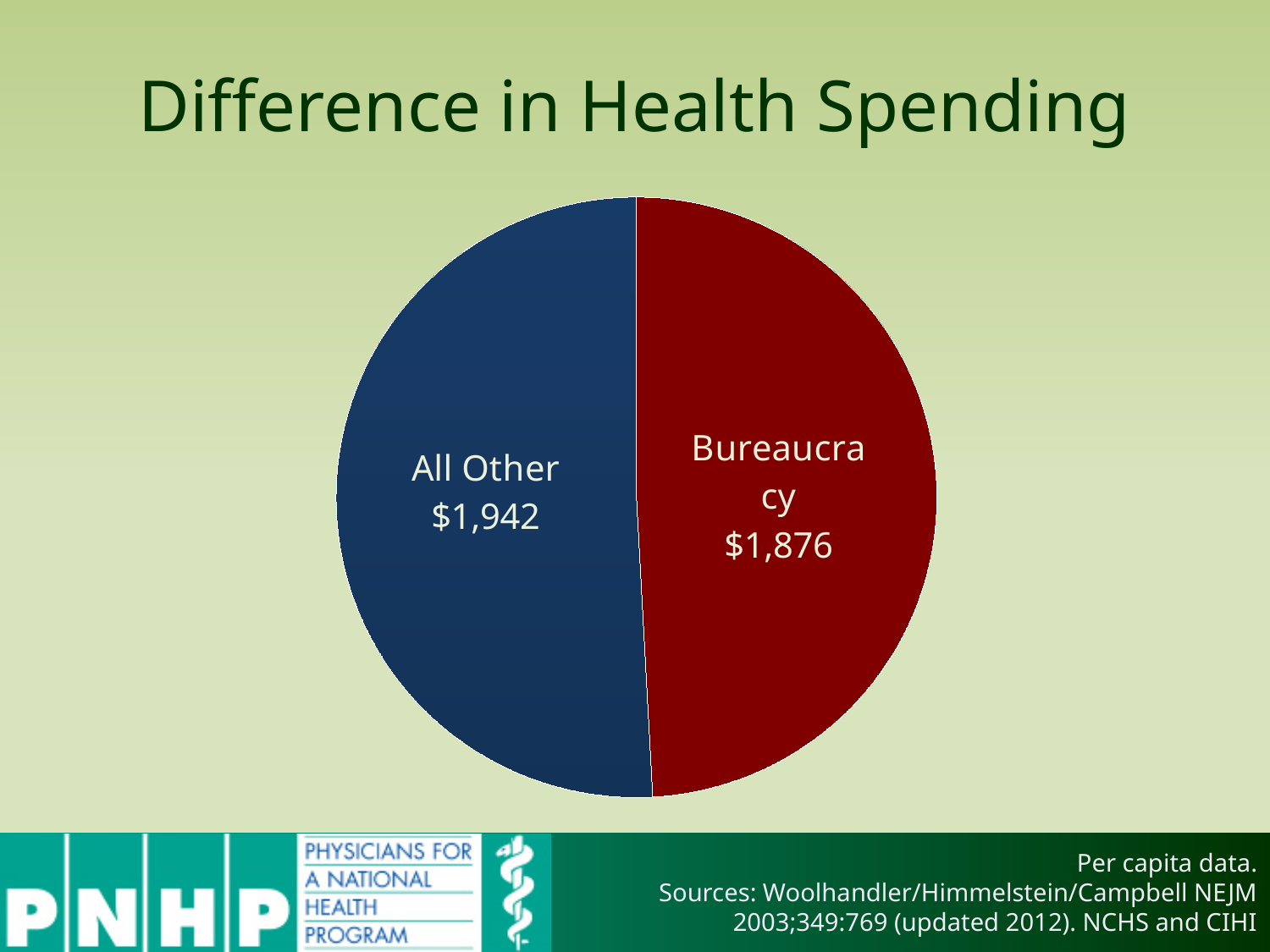
What is the title of the chart? Difference in Health Spending What is the total of the two slices in the pie chart? $3,818 What is the value shown for the Bureaucracy slice? $1,876 What is the value shown for the All Other slice? $1,942 Which slice has the smallest value? Bureaucracy How many slices does the pie chart have? 2 What colour is the Bureaucracy slice? Red Which slice has the largest value? All Other What is the difference between the All Other value and the Bureaucracy value? $66 Which slice has the larger value, All Other or Bureaucracy? All Other What kind of chart is shown on the slide? Pie chart